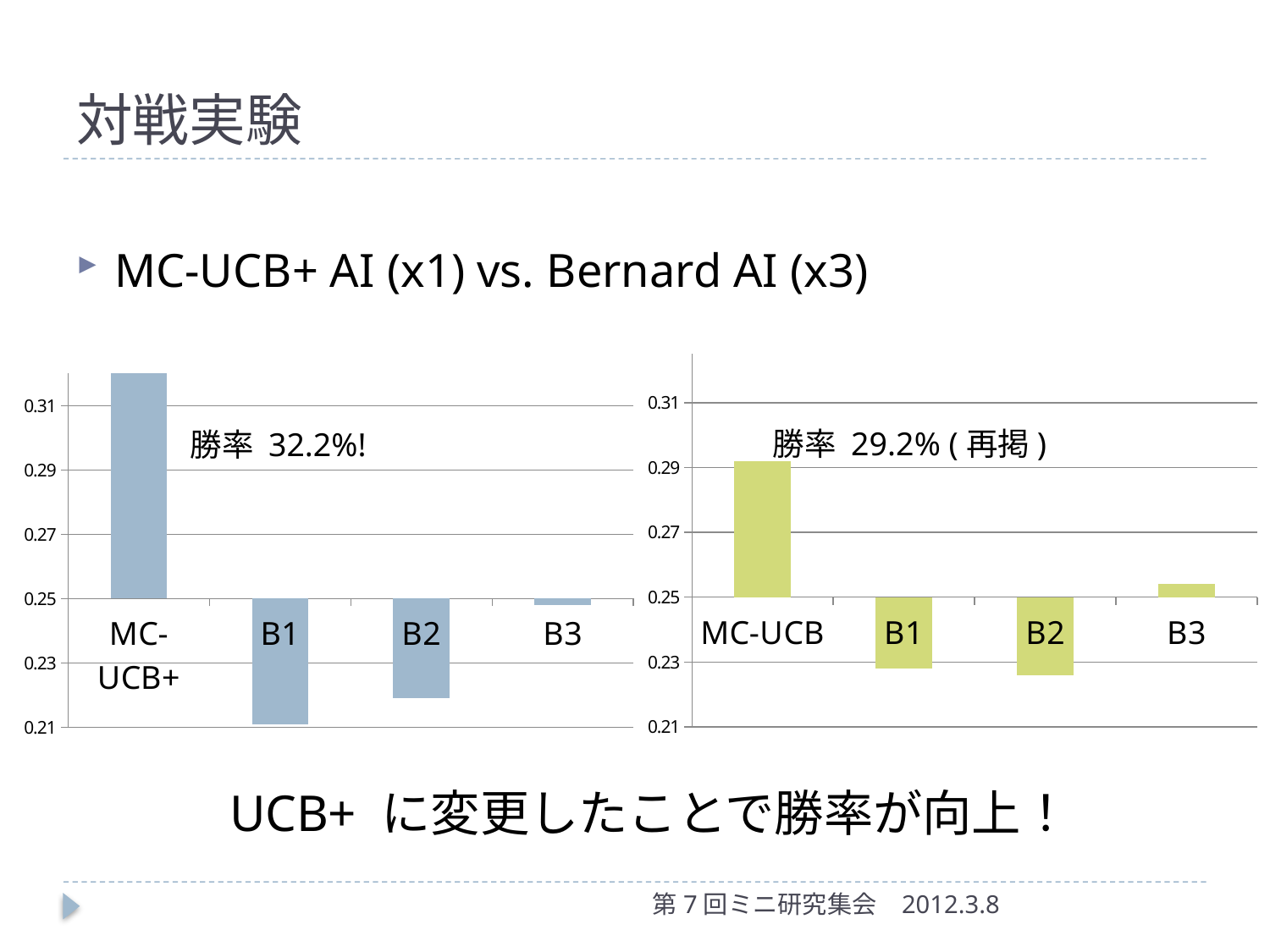
How many categories are shown on the right chart (MC-UCB)? 4 What kind of chart is the left chart (MC-UCB+)? bar chart What win rate (勝率) is annotated on the left chart (MC-UCB+)? 32.2% On the left chart (MC-UCB+), which is larger, the value for B1 or the value for B3? B3 On the left chart (MC-UCB+), which category has the highest value? MC-UCB+ On the left chart (MC-UCB+), is the value for MC-UCB+ greater or less than 0.31? greater On the left chart (MC-UCB+), which category has the lowest value? B1 On the right chart (MC-UCB), is the value for B1 greater or less than 0.25? less On the right chart (MC-UCB), which is larger, the value for MC-UCB or the value for B3? MC-UCB On the right chart (MC-UCB), is the value for MC-UCB greater or less than 0.27? greater On the right chart (MC-UCB), which category has the highest value? MC-UCB